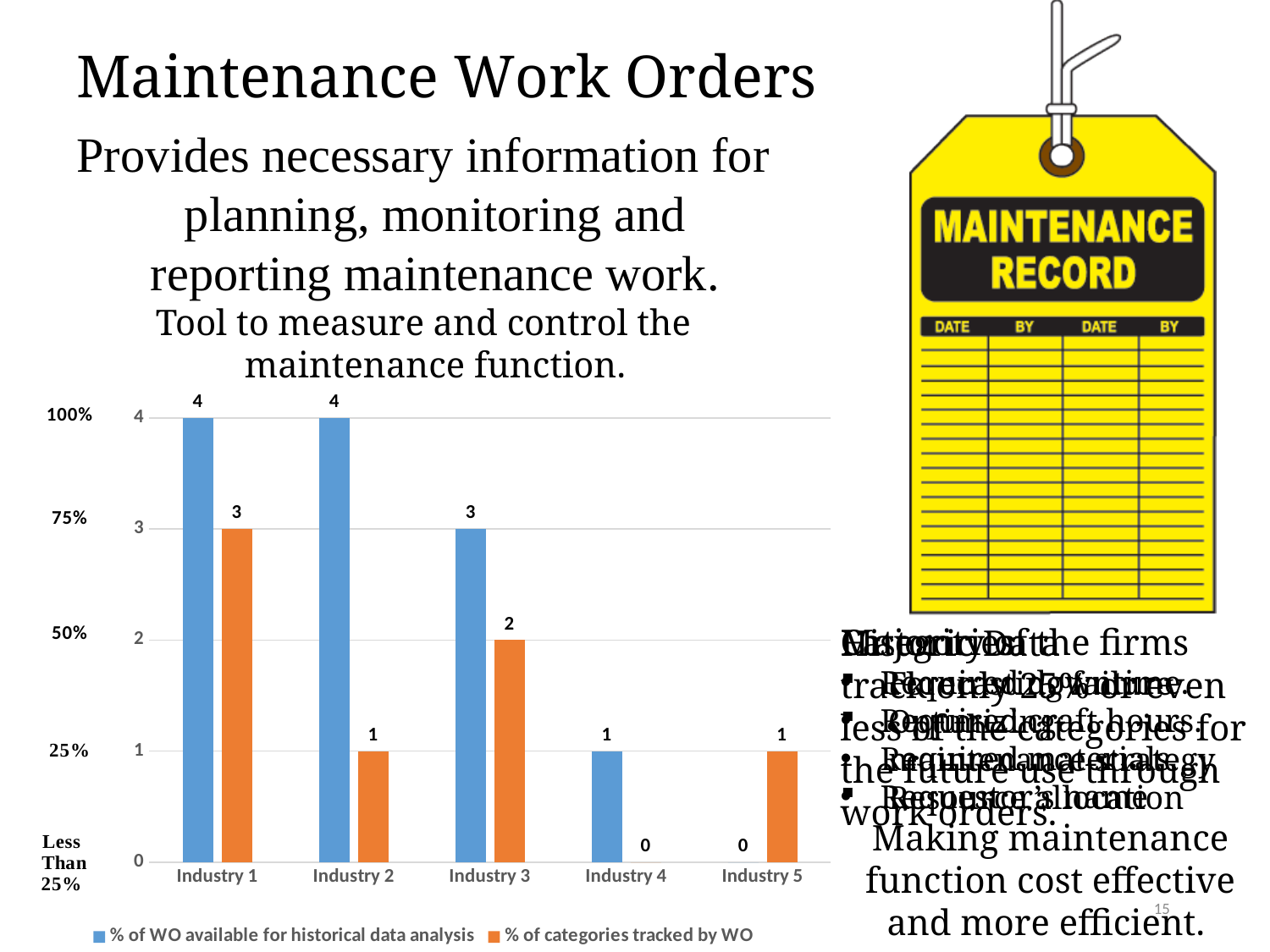
What kind of chart is shown on the slide? bar chart How many series does the chart legend list? 2 Which industry has the highest value for '% of categories tracked by WO'? Industry 1 What is the value of '% of categories tracked by WO' for Industry 4? 0 What is the difference between the '% of WO available for historical data analysis' and '% of categories tracked by WO' values for Industry 2? 3 Which industry has the lowest value for '% of WO available for historical data analysis'? Industry 5 For Industry 3, which is larger: '% of WO available for historical data analysis' or '% of categories tracked by WO'? % of WO available for historical data analysis What is the value of '% of categories tracked by WO' for Industry 2? 1 What is the value of '% of WO available for historical data analysis' for Industry 3? 3 Does the '% of WO available for historical data analysis' series rise or fall from Industry 2 to Industry 5? fall How many industries are shown on the x axis of the chart? 5 Which colour represents '% of categories tracked by WO' in the chart? orange